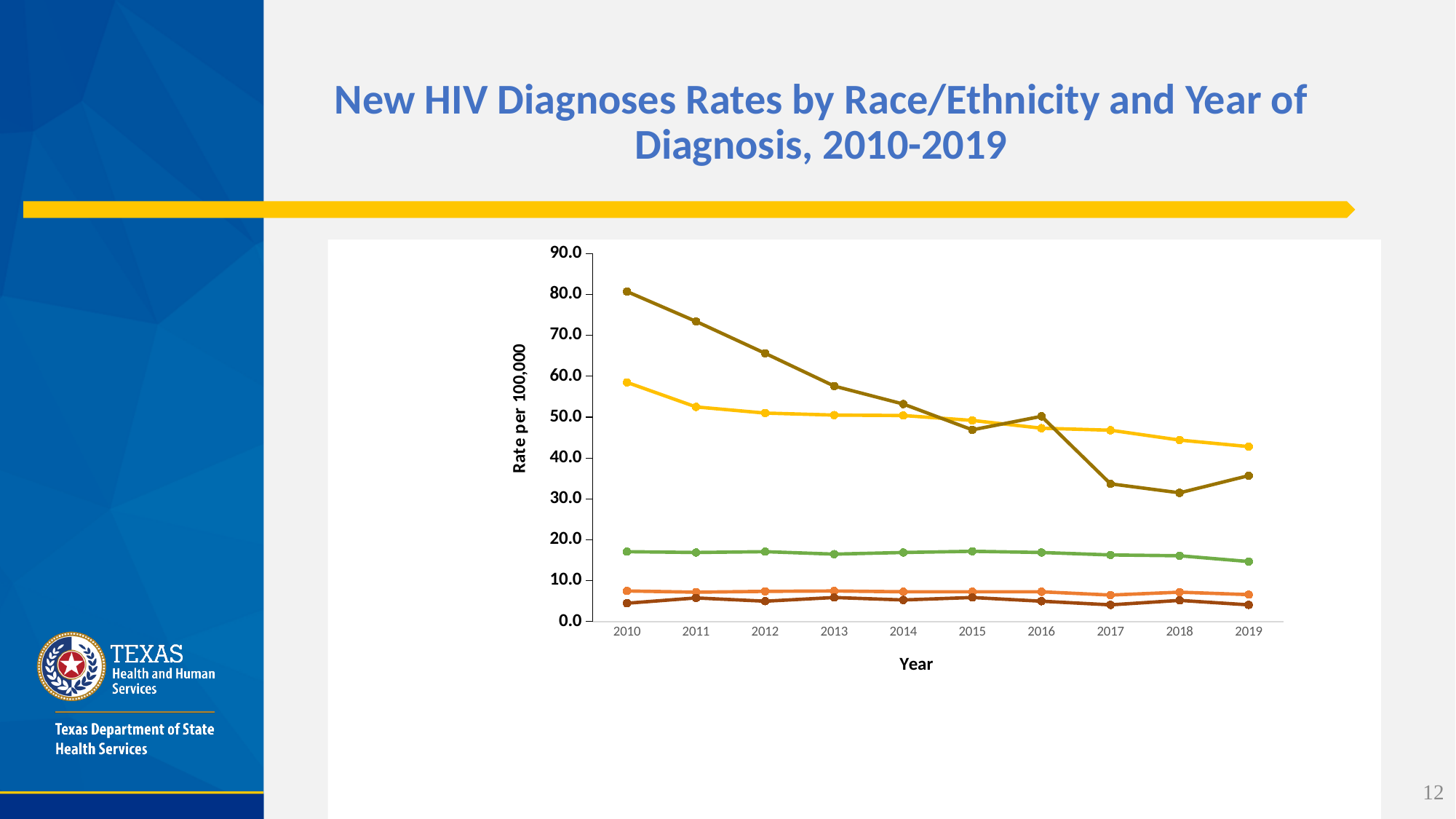
Is the value of the green line in 2019 greater or less than 20? less Does the dark olive line (the highest line in 2010) rise or fall from 2010 to 2019? fall How many years are plotted along the x axis of the chart? 10 What is the title of the y axis on the chart? Rate per 100,000 How many lines are plotted on the chart? 5 In 2019, which line is higher: the yellow line or the dark olive line? the yellow line Is the value of the yellow line in 2010 greater or less than 50? greater Does the yellow line rise or fall from 2010 to 2019? fall What is the title of the x axis on the chart? Year Is the value of the dark olive line in 2010 greater or less than 70? greater What type of chart is shown on the slide? line chart